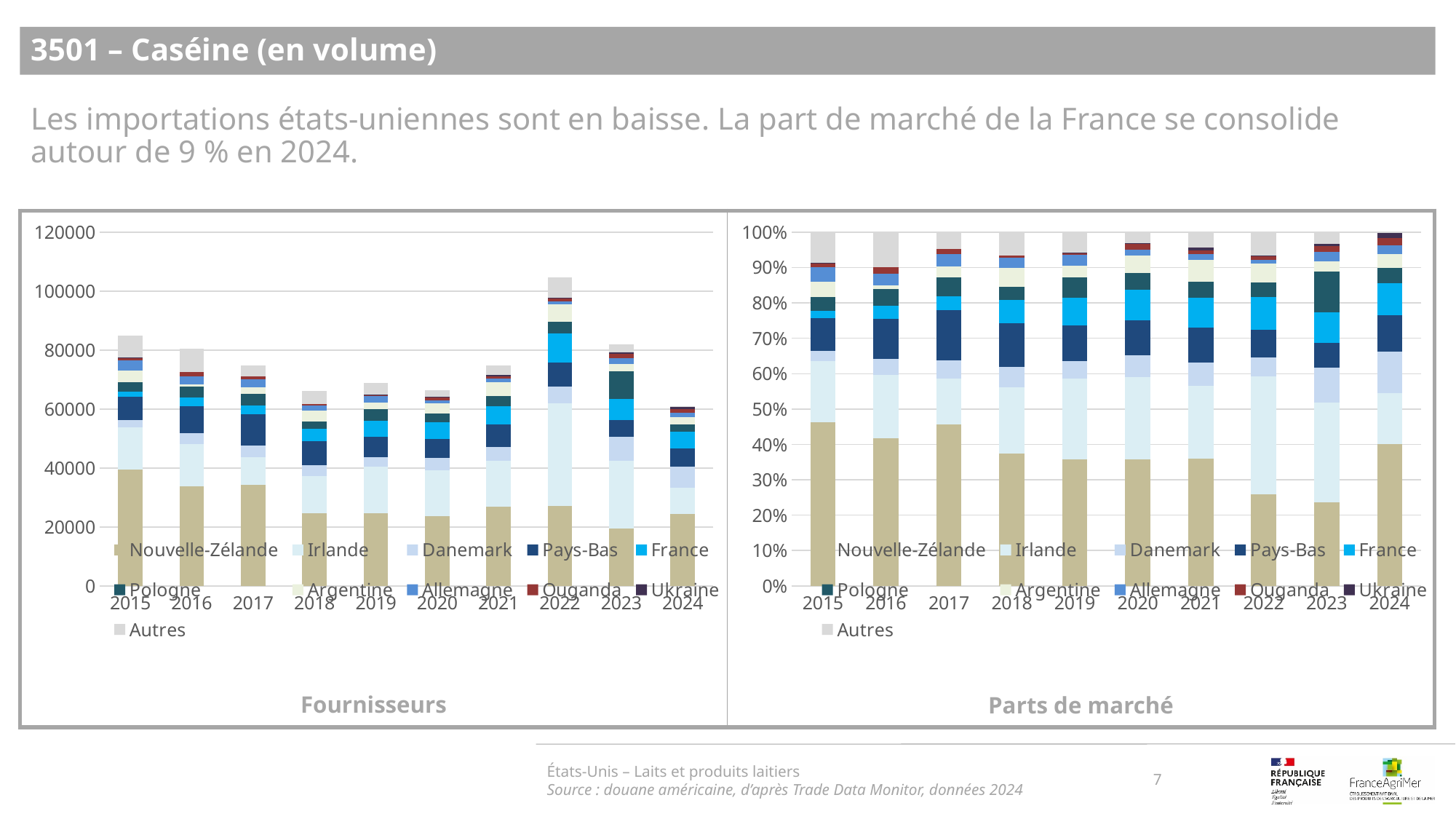
What kind of chart is the 'Fournisseurs' chart on the left? Stacked bar chart In the 'Fournisseurs' chart, is the total bar for 2018 greater or less than 80000? less In the 'Parts de marché' chart, is the share of Nouvelle-Zélande in 2023 greater or less than 30%? less In the 'Parts de marché' chart, is the share of Nouvelle-Zélande in 2015 greater or less than 40%? greater In the 'Fournisseurs' chart, which total bar is larger, 2022 or 2023? 2022 In the 'Fournisseurs' chart, do the total bars rise or fall from 2022 to 2024? fall In the 'Fournisseurs' chart, which year has the lowest total bar? 2024 What is the title of the chart on the right side of the slide? Parts de marché In the 'Fournisseurs' chart, which year has the highest total bar? 2022 How many years are shown on the x axis of the 'Parts de marché' chart? 10 How many series does the legend of the 'Fournisseurs' chart list? 11